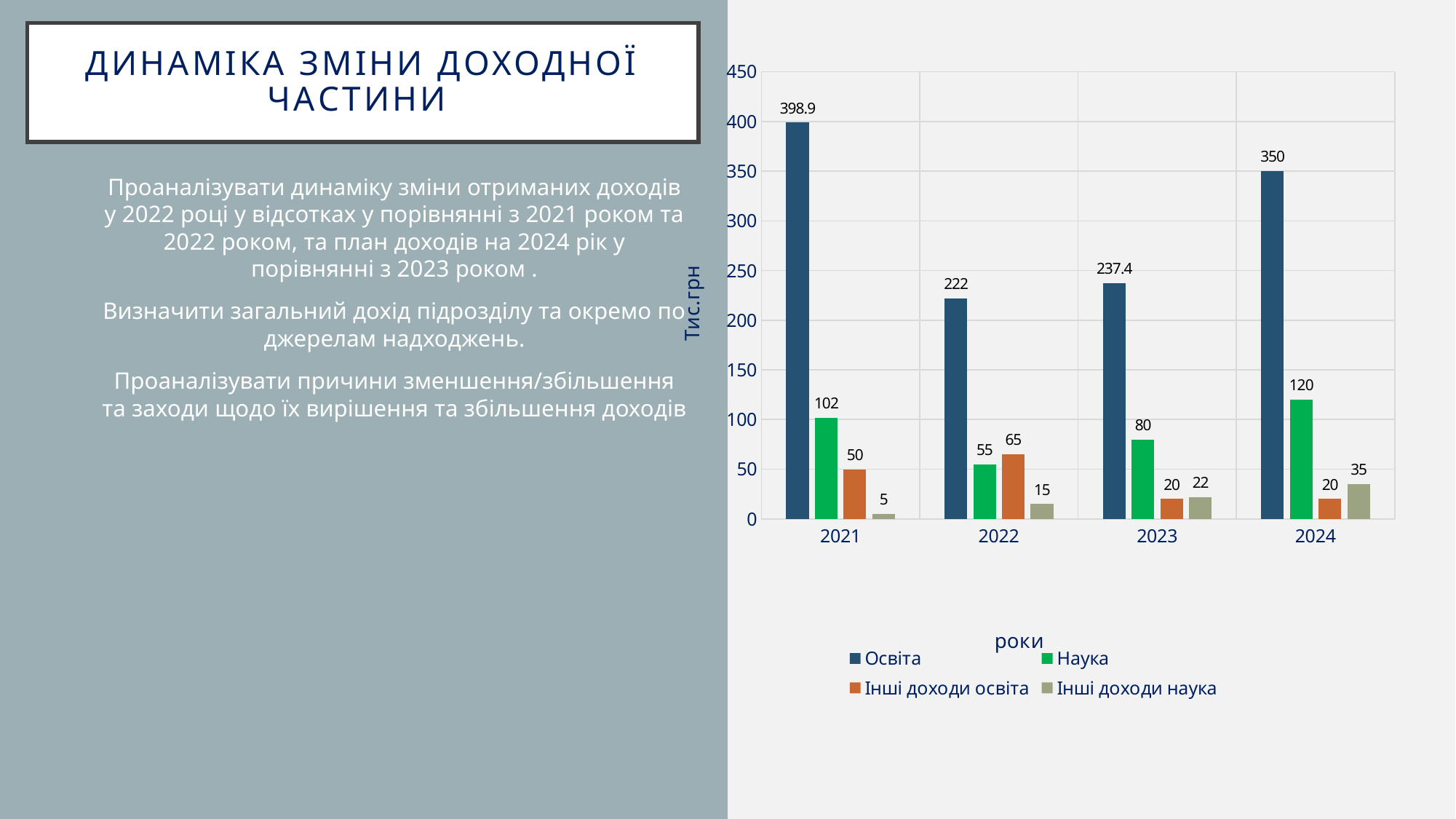
What is the difference between the Освіта values for 2024 and 2023? 112.6 What is the value for Інші доходи освіта in 2022? 65 How many series does the legend list? 4 What is the value for Освіта in 2021? 398.9 What is the value for Наука in 2024? 120 In which year is the Освіта value highest? 2021 What is the label of the vertical axis? Тис.грн Which is larger in 2022: Наука or Інші доходи освіта? Інші доходи освіта How many years are shown on the x axis? 4 What kind of chart is shown on the slide? Bar chart In which year is the Наука value lowest? 2022 What is the value for Інші доходи наука in 2021? 5